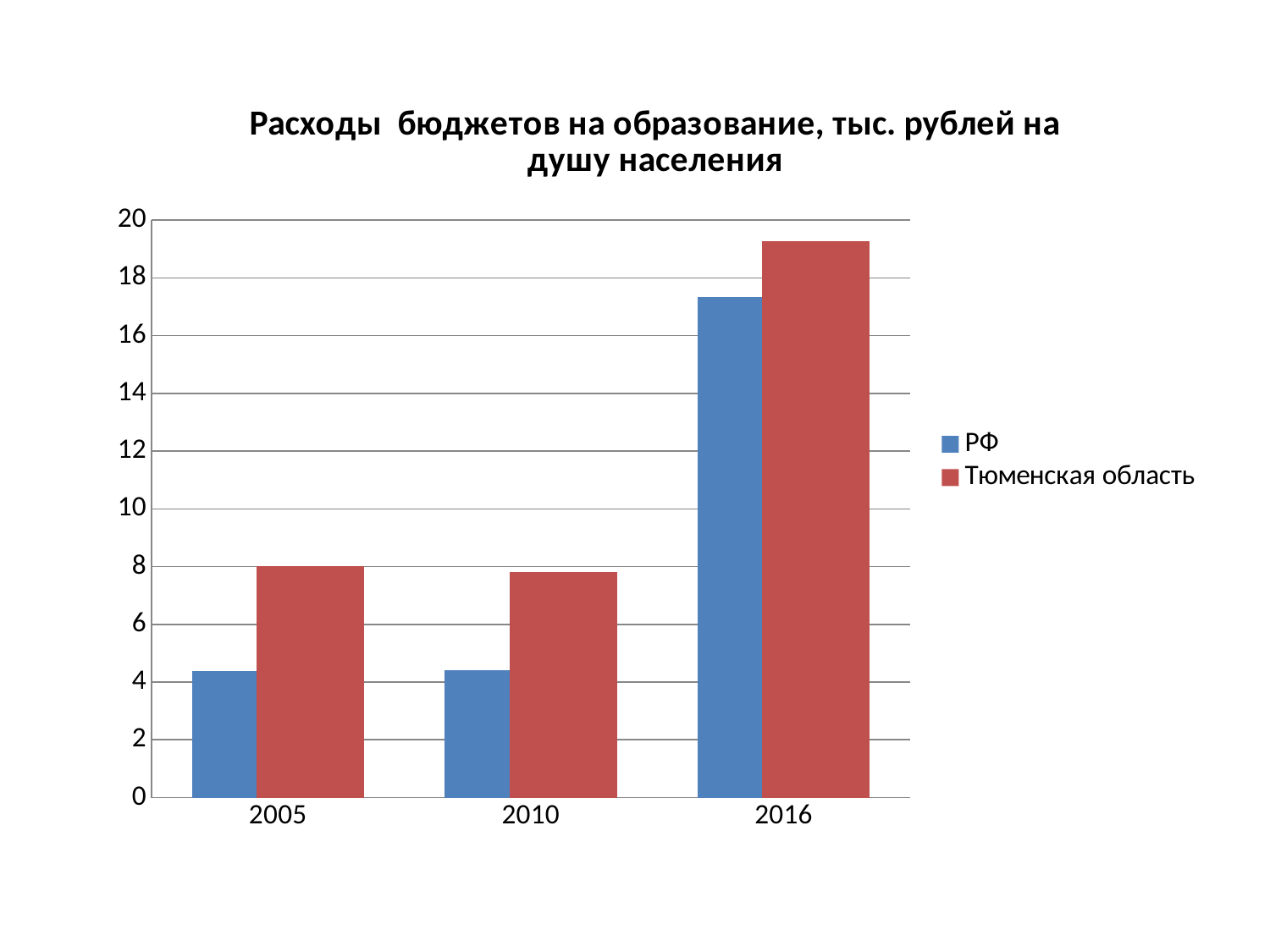
Is the value for РФ in 2005 greater or less than 6? less In which year is the value for Тюменская область highest? 2016 In 2016, which is larger: the value for РФ or for Тюменская область? Тюменская область What is the title of the chart? Расходы бюджетов на образование, тыс. рублей на душу населения Which series is shown in red in the legend? Тюменская область In which year is the value for РФ highest? 2016 How many years are shown on the x axis? 3 What kind of chart is shown on the slide? bar chart Does the value for РФ rise or fall from 2010 to 2016? rise How many series does the legend list? 2 Is the value for РФ in 2016 greater or less than 16? greater Is the value for Тюменская область in 2016 greater or less than 18? greater